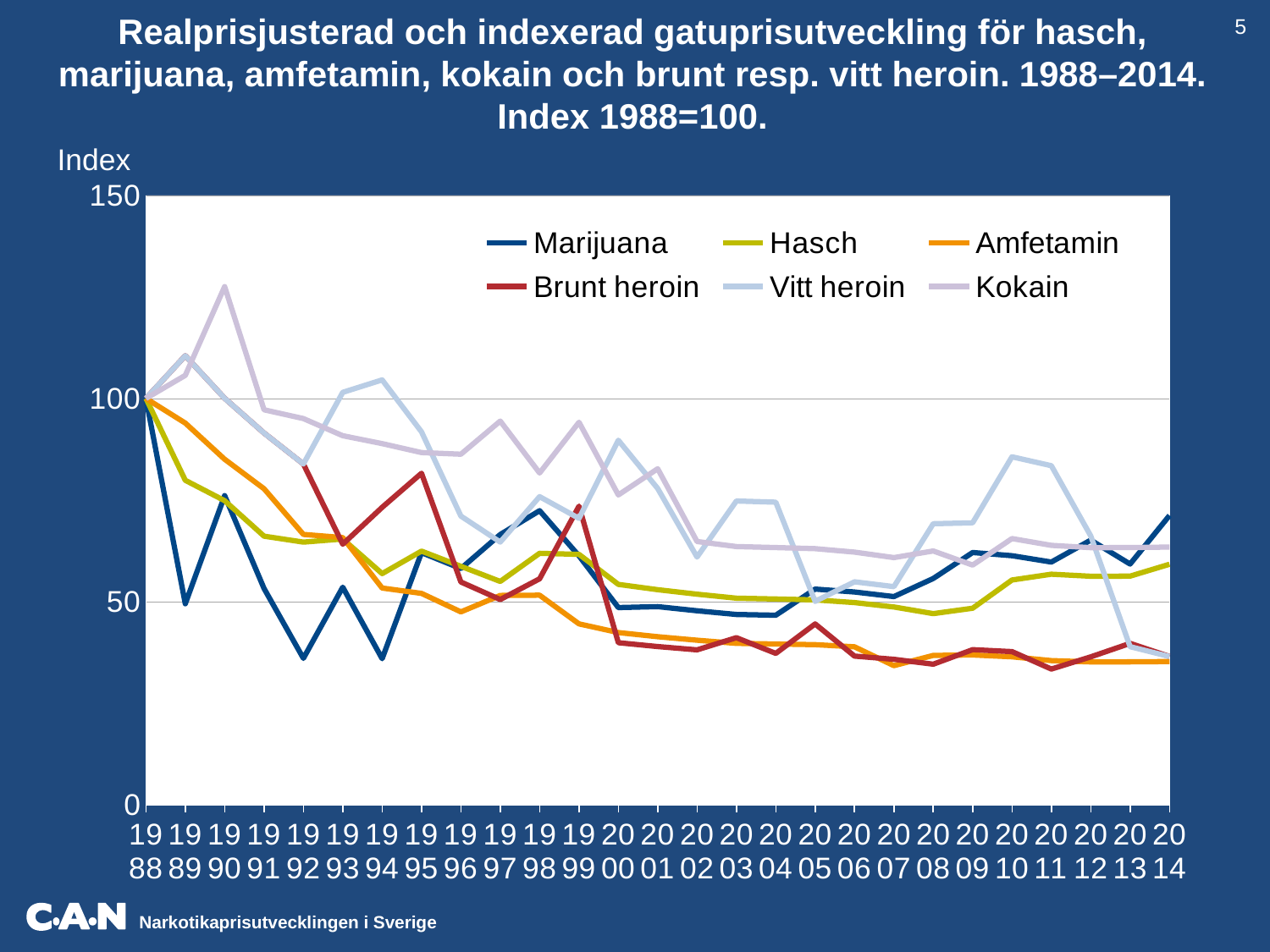
Is the value for Vitt heroin in 2013 greater or less than 50? less How many series does the legend list? 6 How many years are shown along the x axis? 27 Which base year is the index set to 100 according to the title? 1988 Is the value for Kokain in 1990 greater or less than 100? greater Is the value for Marijuana in 1992 greater or less than 50? less Which series has the highest value in 2010? Vitt heroin Which series has the highest value in 1990? Kokain Does the Amfetamin series generally rise or fall from 1988 to 2014? fall What is the index value for all series in 1988? 100 What kind of chart is shown on the slide? line chart